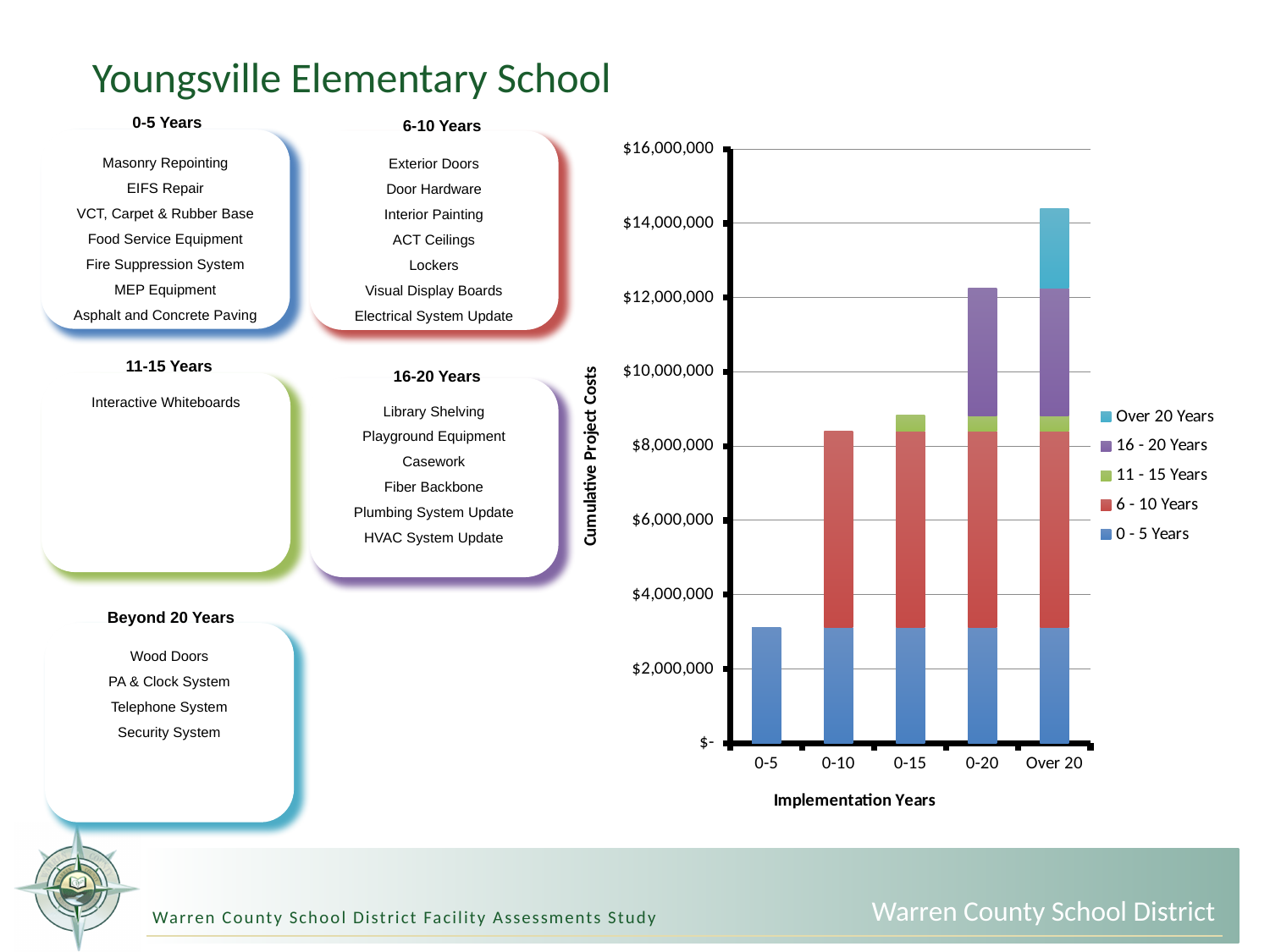
How many bars (implementation year categories) are plotted on the x axis? 5 How many series does the chart legend list? 5 Which implementation year category has the lowest cumulative project cost? 0-5 Is the cumulative project cost for the Over 20 bar greater or less than $14,000,000? greater Which implementation year category has the highest cumulative project cost? Over 20 Which bar is taller, 0-20 or 0-10? 0-20 Is the cumulative project cost for the 0-5 bar greater or less than $4,000,000? less Is the cumulative project cost for the 0-10 bar greater or less than $8,000,000? greater What kind of chart is shown on the slide? Stacked bar chart What is the title of the chart's vertical axis? Cumulative Project Costs Do the cumulative project costs rise or fall moving from 0-5 to Over 20 along the x axis? Rise